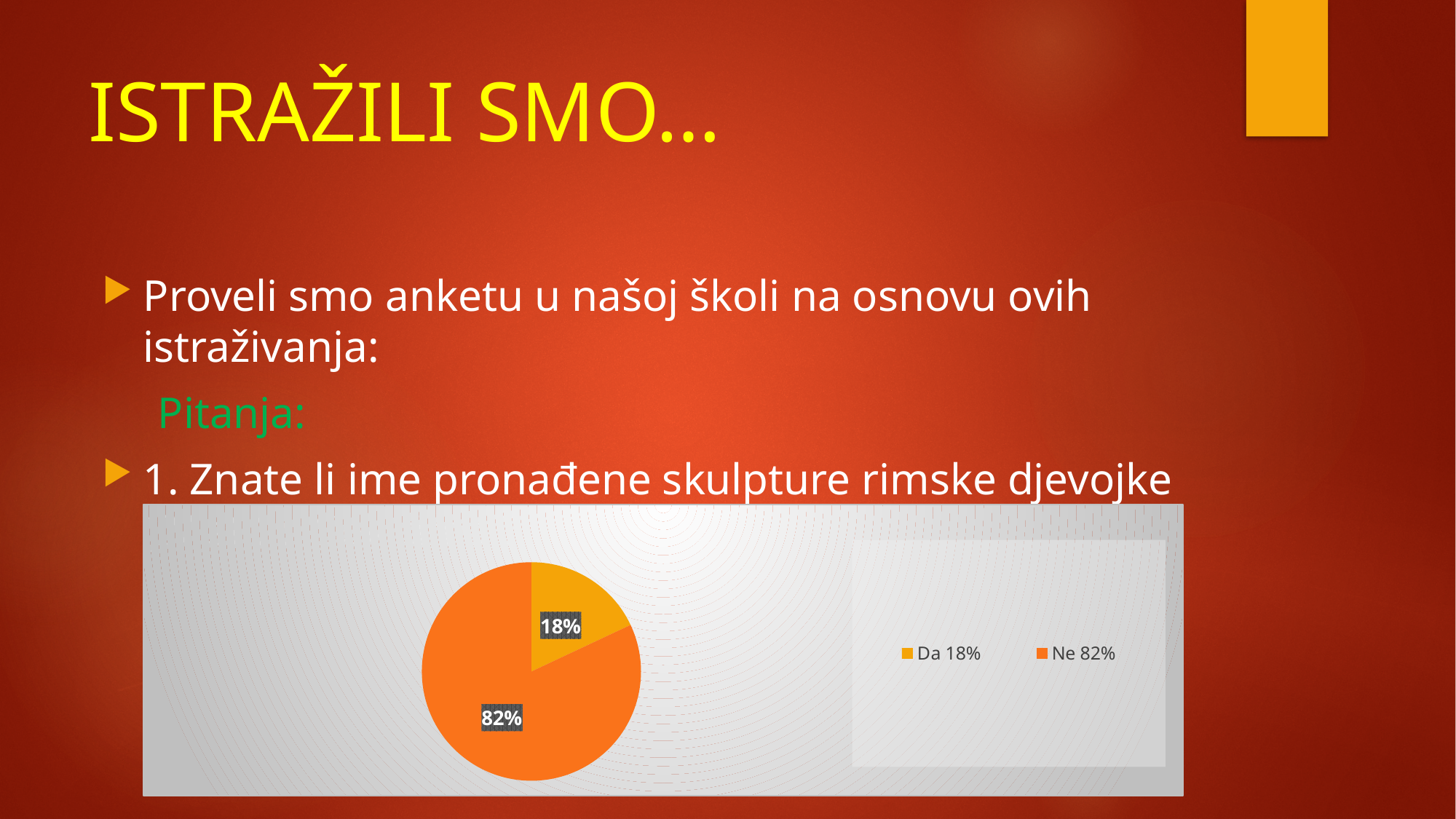
How many entries does the legend list? 2 What kind of chart is shown on the slide? pie chart What share of the pie does the "Da" slice represent? 18% What are the two legend entries of the pie chart? Da 18% and Ne 82% Which is larger, the "Da" slice or the "Ne" slice? Ne What colour is the "Ne" slice of the pie chart? orange What is the difference in percentage points between the "Ne" slice and the "Da" slice? 64 How many slices does the pie chart have? 2 What share of the pie does the "Ne" slice represent? 82% Which slice of the pie is the largest? Ne Which slice of the pie is the smallest? Da